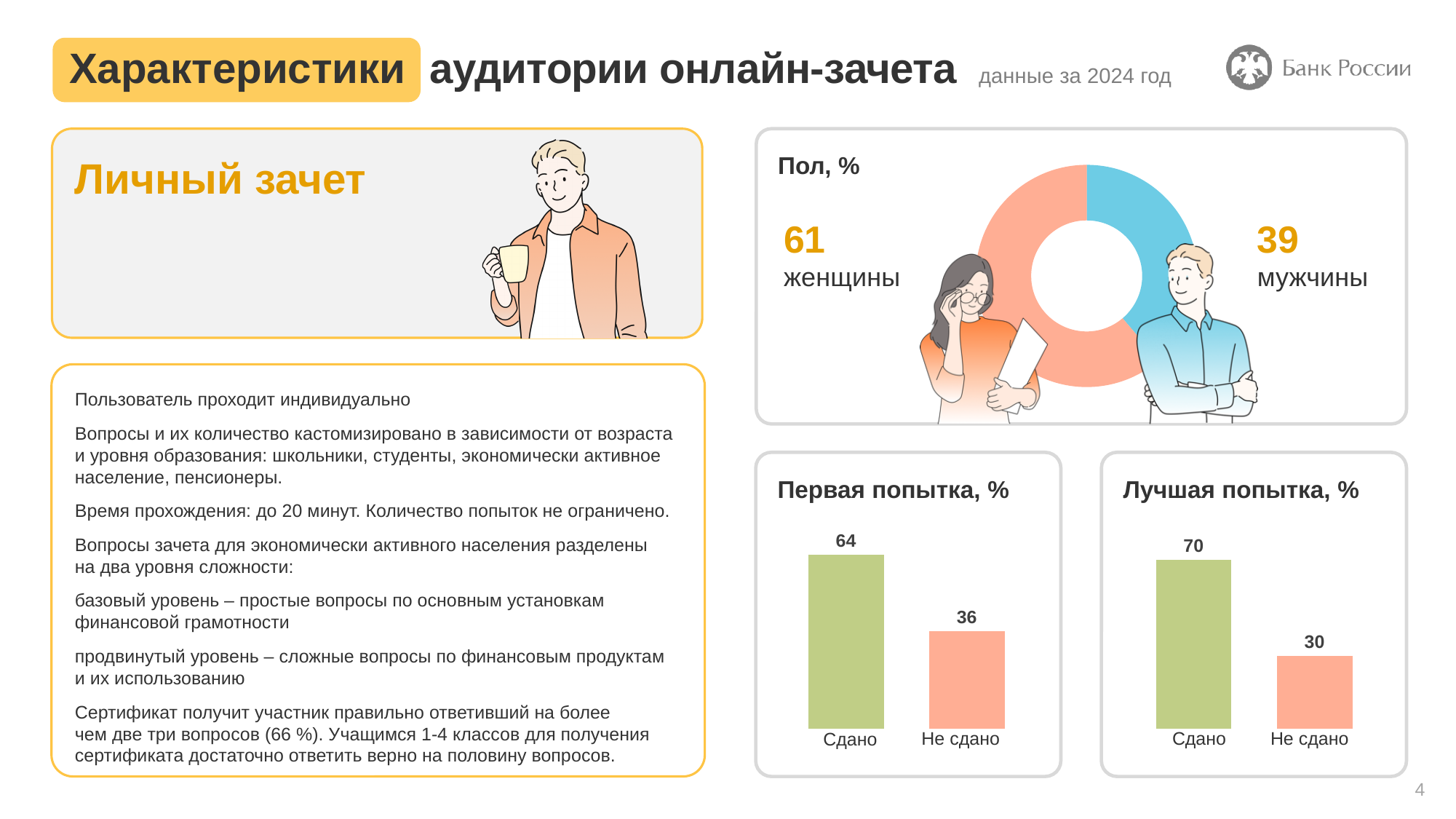
What kind of chart is the 'Пол, %' chart? donut chart In the chart titled 'Первая попытка, %', what is the value for Сдано? 64 In the chart titled 'Лучшая попытка, %', which category is lowest? Не сдано In the chart titled 'Пол, %', which category has the larger share? женщины In the chart titled 'Пол, %', what is the value for мужчины? 39 Which is larger: Сдано in 'Первая попытка, %' or Сдано in 'Лучшая попытка, %'? Сдано in 'Лучшая попытка, %' In the chart titled 'Первая попытка, %', what is the difference between Сдано and Не сдано? 28 In the chart titled 'Лучшая попытка, %', what is the value for Сдано? 70 What kind of chart is the 'Первая попытка, %' chart? bar chart In the chart titled 'Пол, %', what is the value for женщины? 61 In the chart titled 'Лучшая попытка, %', what is the value for Не сдано? 30 In the chart titled 'Первая попытка, %', what is the value for Не сдано? 36